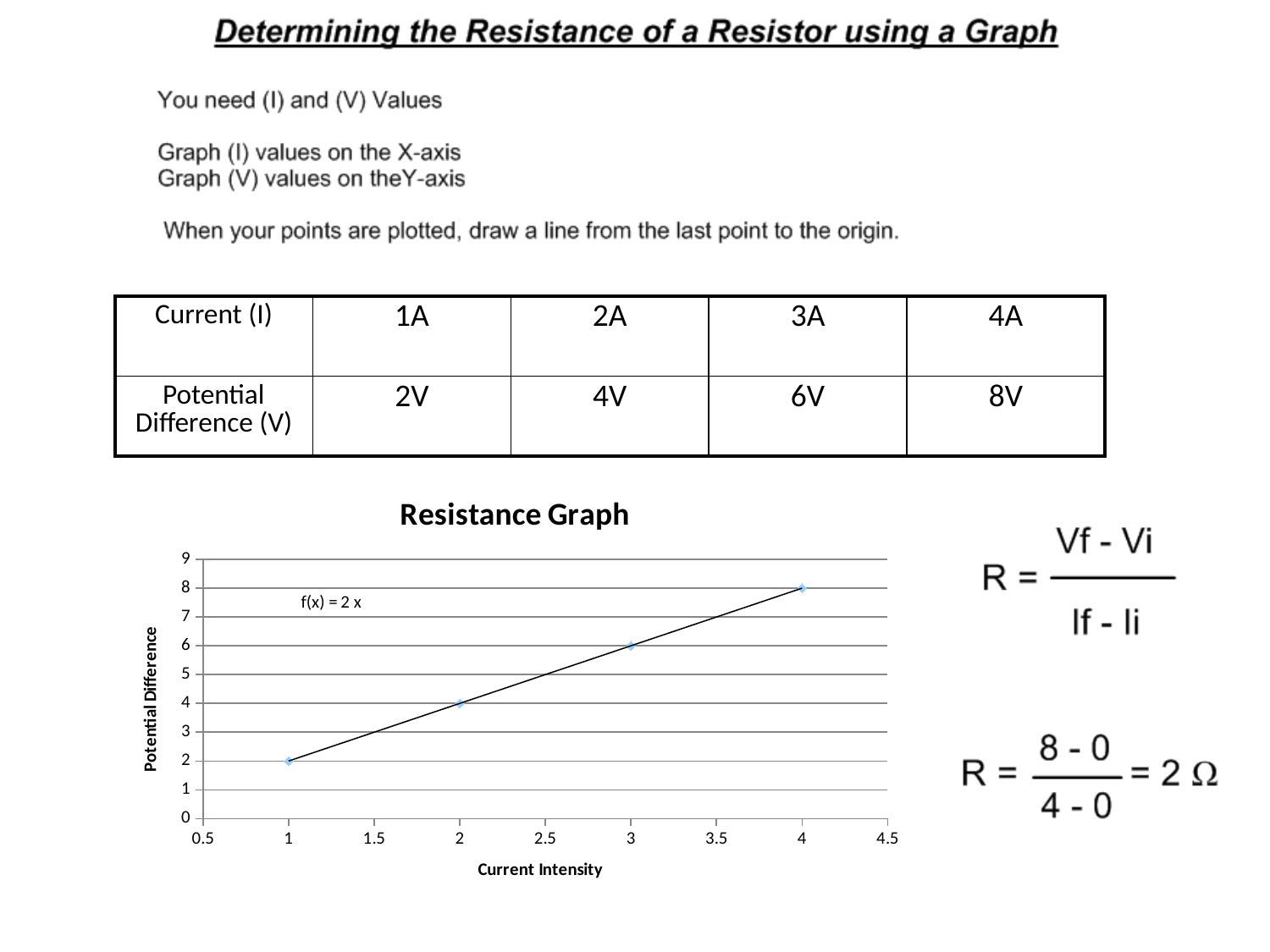
At which current intensity is the potential difference lowest? 1 What is the potential difference when the current intensity is 4? 8 Does the potential difference rise or fall as current intensity increases? rise What is the difference in potential difference between current intensity 4 and current intensity 2? 4 What is the title of the chart? Resistance Graph Which has a larger potential difference: current intensity 2 or current intensity 3? current intensity 3 What is the potential difference when the current intensity is 3? 6 What kind of chart is the Resistance Graph? scatter chart with a line What equation is shown for the trendline on the chart? f(x) = 2 x How many data points are plotted on the Resistance Graph? 4 What is the potential difference when the current intensity is 1? 2 At which current intensity is the potential difference highest? 4